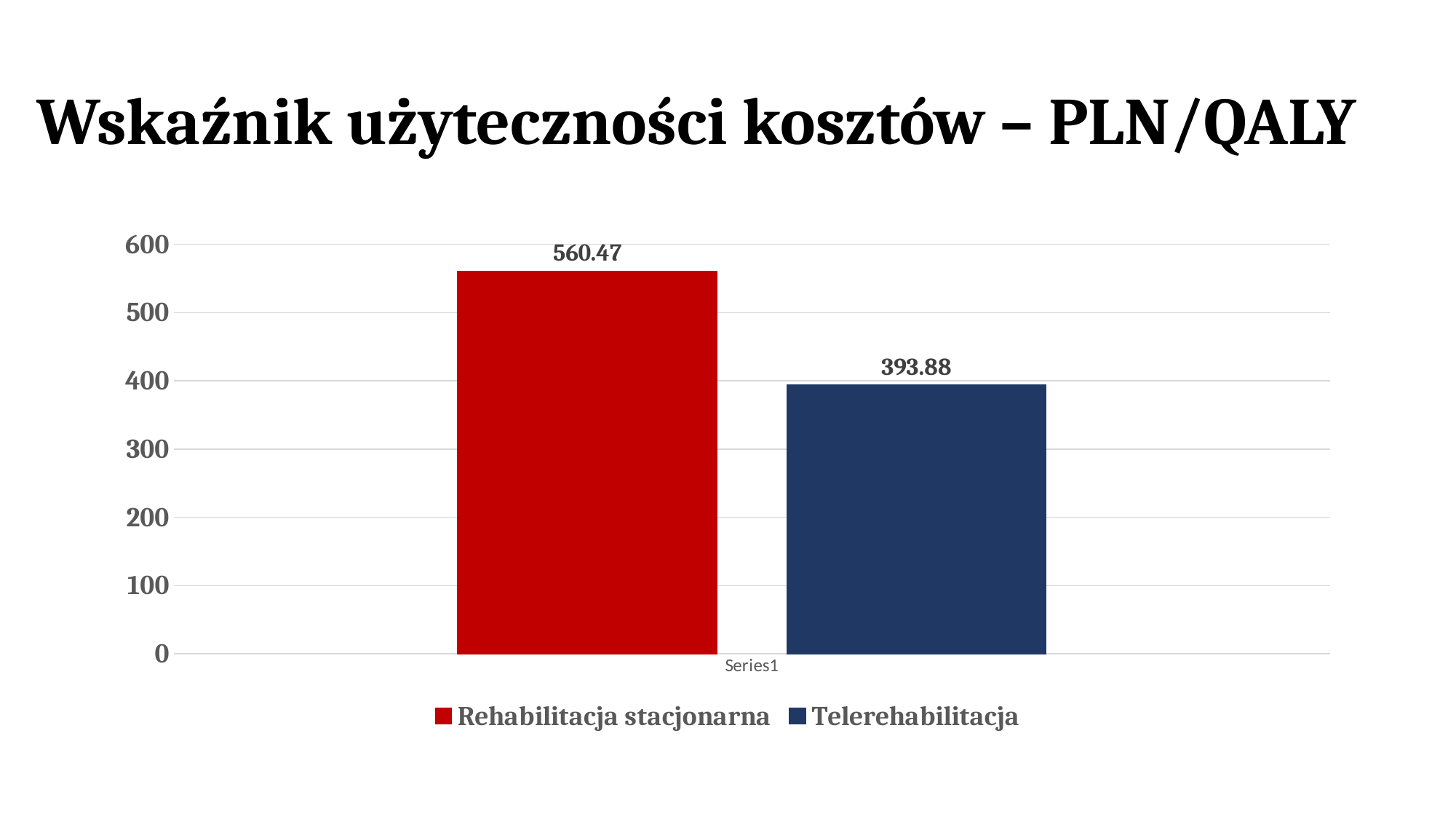
What colour is the bar for Telerehabilitacja? dark blue Which series has the higher value? Rehabilitacja stacjonarna Is the value for Telerehabilitacja greater or less than 400? less What is the difference between the values for Rehabilitacja stacjonarna and Telerehabilitacja? 166.59 How many bars are plotted in the chart? 2 How many series does the legend list? 2 Is the value for Rehabilitacja stacjonarna greater or less than 500? greater What is the title of the slide? Wskaźnik użyteczności kosztów – PLN/QALY What is the value for Telerehabilitacja? 393.88 Which series has the lower value? Telerehabilitacja What kind of chart is shown on the slide? bar chart What is the value for Rehabilitacja stacjonarna? 560.47